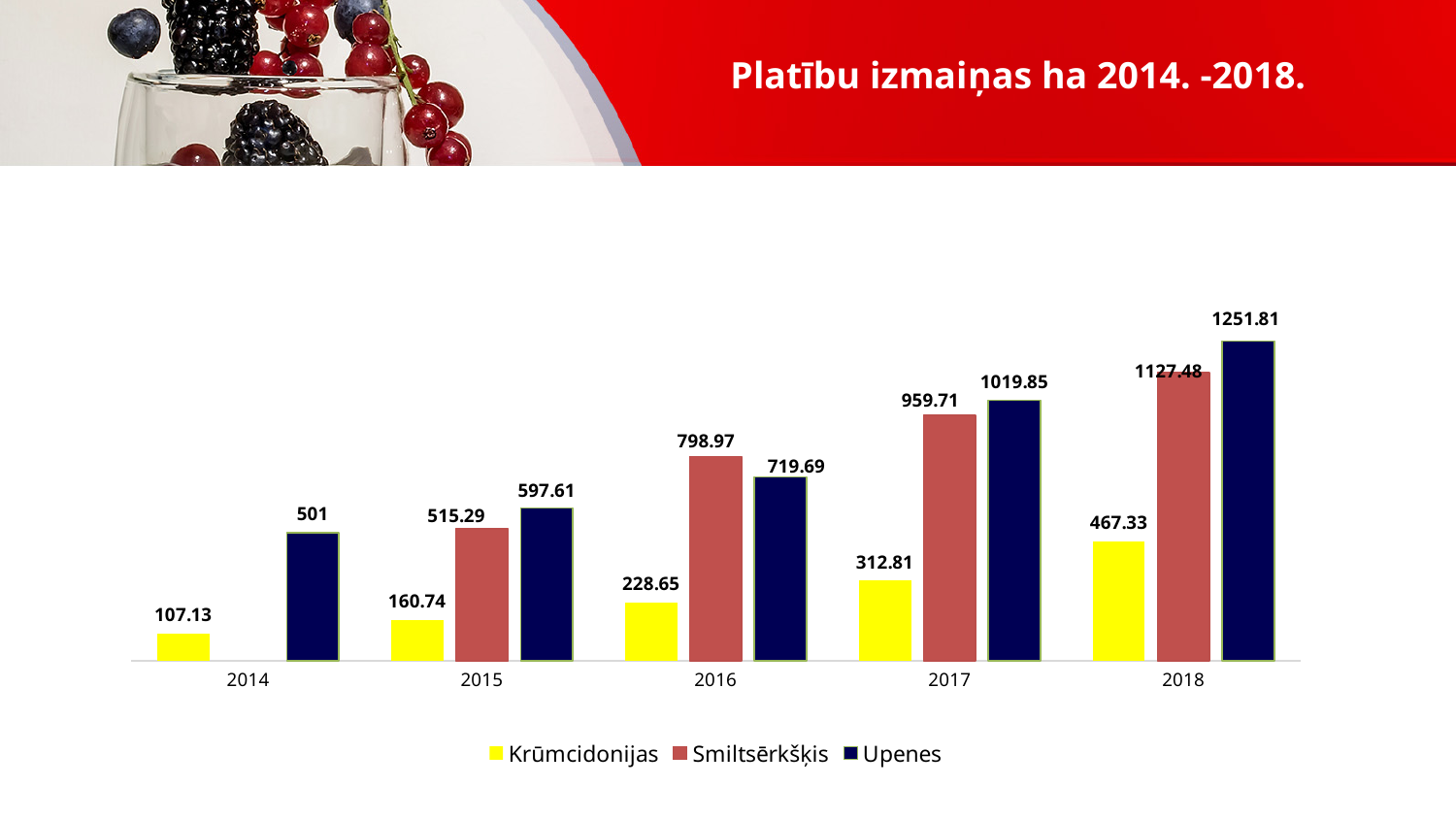
What is the value for Upenes in 2018? 1251.81 How many series does the legend list? 3 What is the value for Krūmcidonijas in 2014? 107.13 In which year is the Upenes value lowest? 2014 What is the value for Smiltsērkšķis in 2016? 798.97 What kind of chart is shown on the slide? Bar chart In 2016, which is larger: Smiltsērkšķis or Upenes? Smiltsērkšķis Do the Krūmcidonijas values rise or fall from 2014 to 2018? Rise How many years are shown on the x axis? 5 What is the value for Upenes in 2015? 597.61 What is the difference between the Upenes and Smiltsērkšķis values in 2018? 124.33 In which year is the Krūmcidonijas value highest? 2018